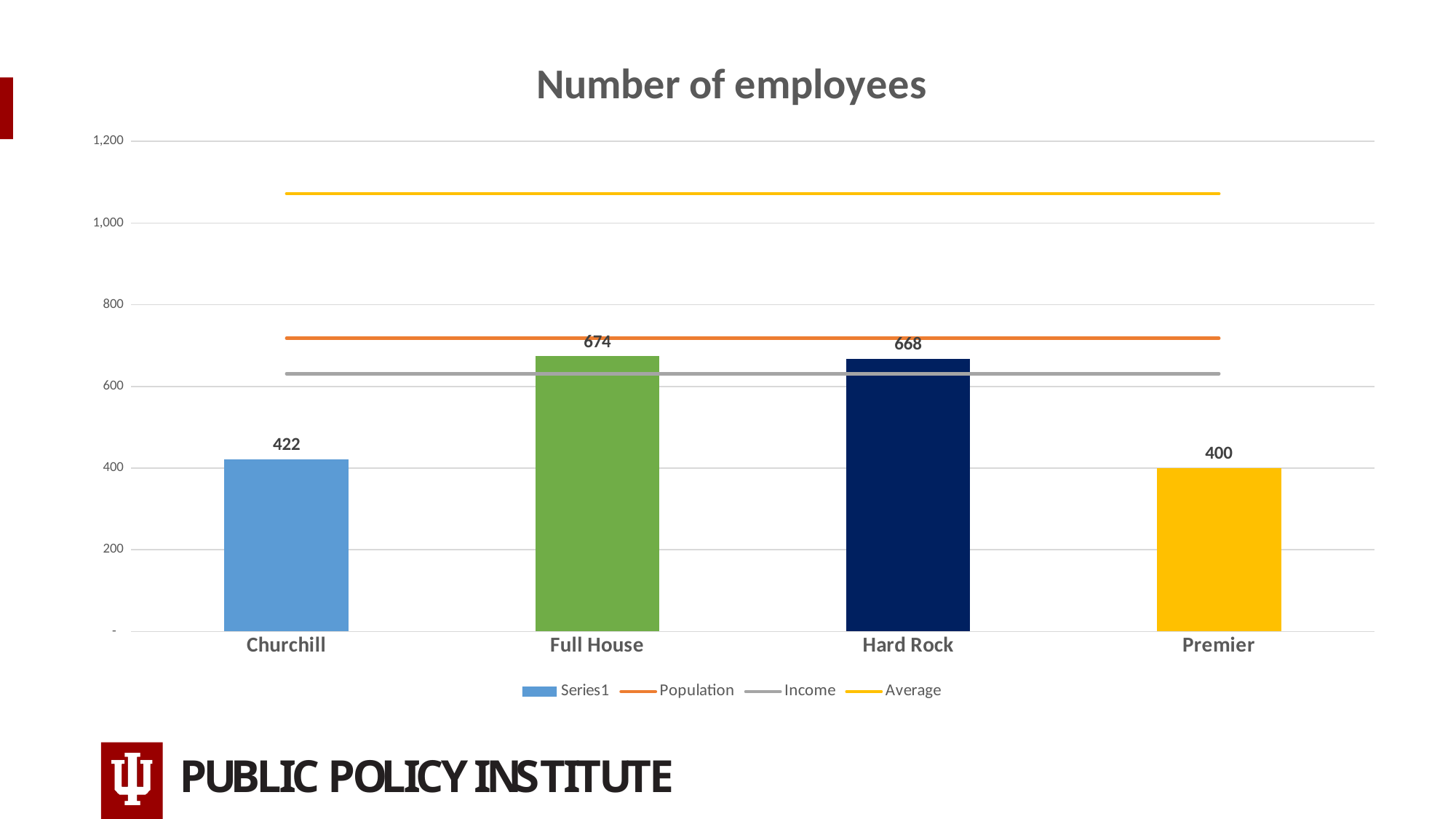
What is the number of employees for Full House? 674 What is the difference in number of employees between Full House and Hard Rock? 6 Which category has the lowest number of employees? Premier Is the value of the Population line greater or less than 800? less Which has more employees, Hard Rock or Churchill? Hard Rock Which category has the highest number of employees? Full House What is the number of employees for Churchill? 422 What is the number of employees for Premier? 400 What is the difference in number of employees between Churchill and Premier? 22 How many series does the legend list? 4 How many categories are shown on the x axis? 4 Is the value of the Average line greater or less than 1,000? greater